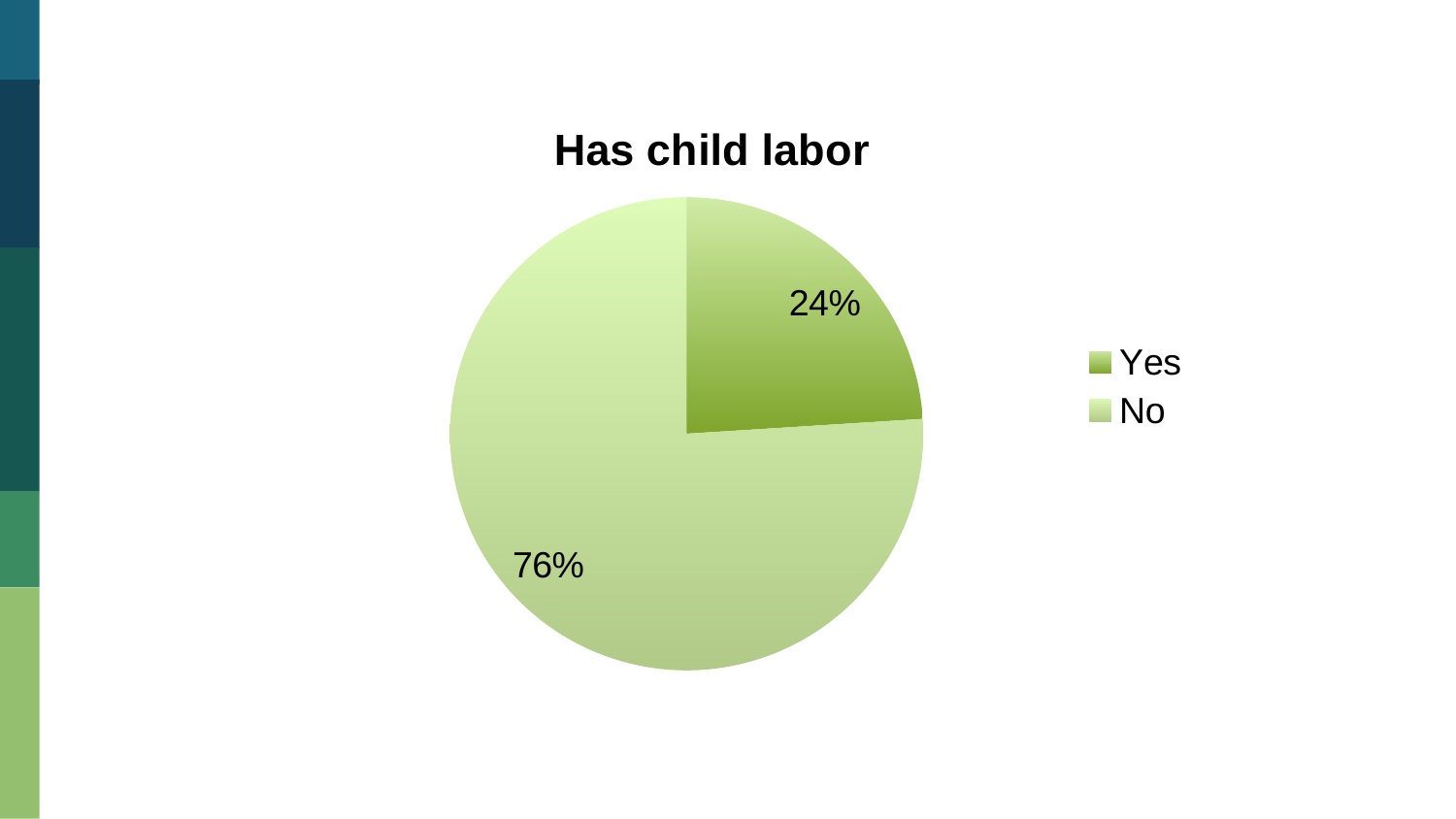
Which legend entry is shown in the darker green colour? Yes What share of the pie is labelled "Yes"? 24% What share of the pie is labelled "No"? 76% What kind of chart is shown on the slide? pie chart What is the title of the chart? Has child labor Which category has the smallest slice of the pie? Yes How many entries does the legend list? 2 Which category has the largest slice of the pie? No Which is larger, the "Yes" slice or the "No" slice? No How many slices does the pie chart have? 2 What is the difference in percentage points between the "No" slice and the "Yes" slice? 52